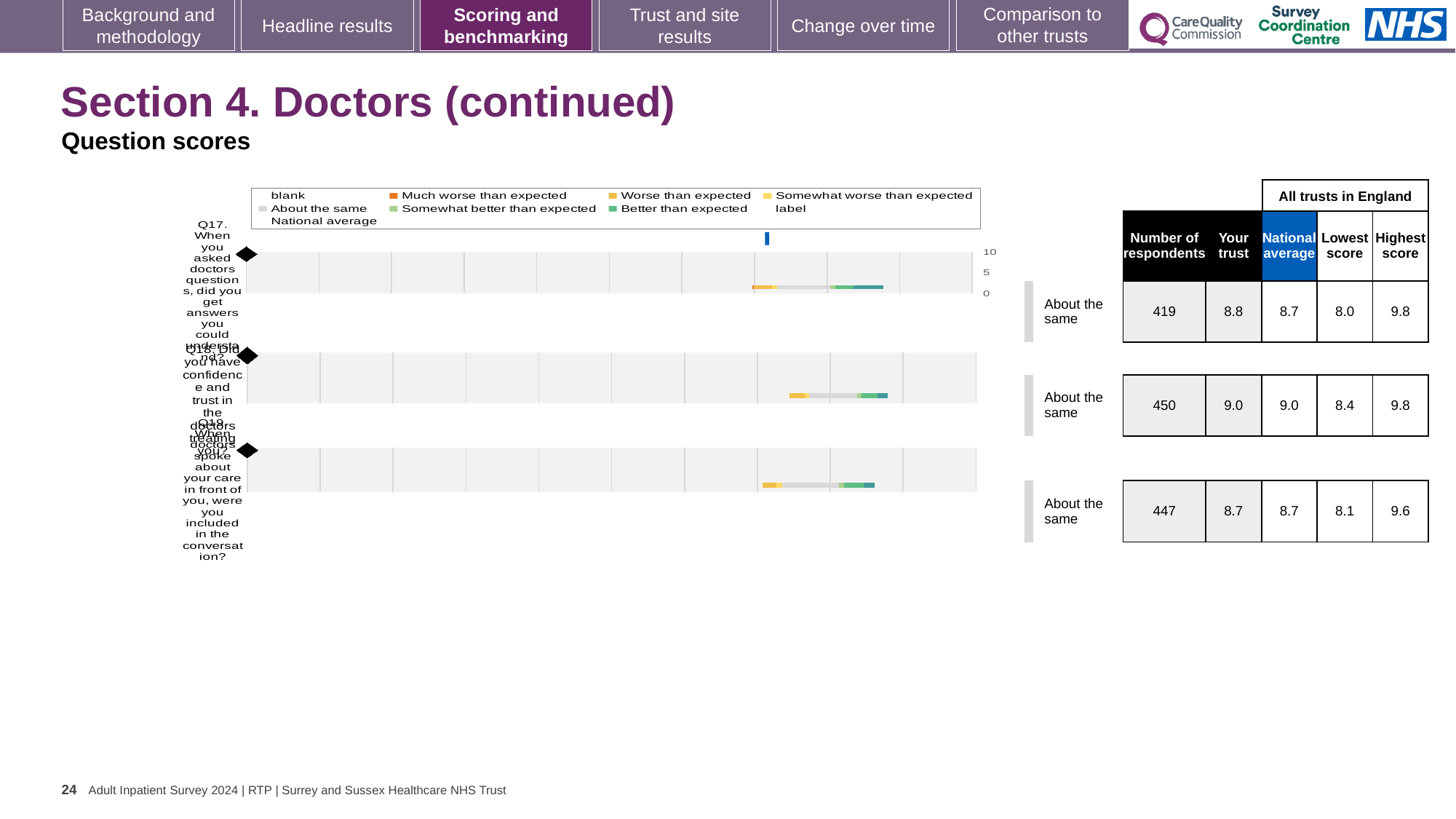
What kind of chart is shown on the slide? bar chart According to the table beside the chart, is the 'Your trust' score for Q18 larger or smaller than that for Q19? larger How many questions (categories) are plotted on the chart? 3 What is the highest tick value shown on the chart's axis? 10 What benchmark category is shown next to the chart for each of the three questions? About the same According to the table beside the chart, what is the national average for Q18 (Did you have confidence and trust in the doctors treating you?)? 9.0 According to the table beside the chart, which question has the lowest number of respondents? Q17 According to the table beside the chart, how many respondents answered Q19 (When doctors spoke about your care in front of you, were you included in the conversation?)? 447 According to the table beside the chart, what is the difference between the highest score and the lowest score for Q19? 1.5 According to the table beside the chart, which question has the highest 'Your trust' score? Q18 According to the table beside the chart, what is the 'Your trust' score for Q17 (When you asked doctors questions, did you get answers you could understand?)? 8.8 Which colour does the legend use for 'Much worse than expected'? orange